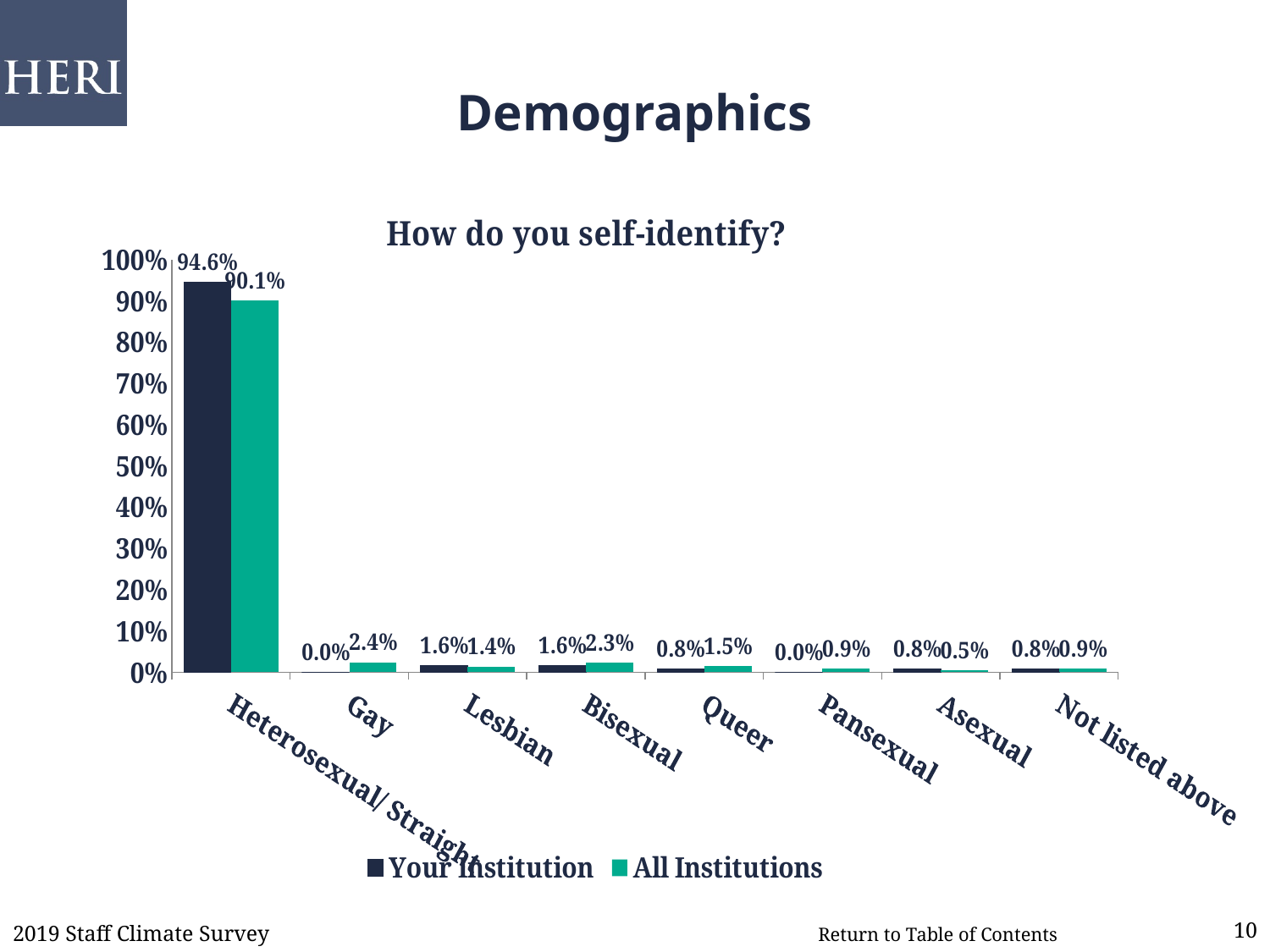
What kind of chart is shown on the slide? Bar chart What is the title of the chart? How do you self-identify? What is the Your Institution value for Bisexual? 1.6% Is the Your Institution value for Heterosexual/Straight greater or less than 90%? greater Which category has the highest value for All Institutions? Heterosexual/Straight What is the difference between the Your Institution and All Institutions values for Heterosexual/Straight? 4.5% What is the All Institutions value for Gay? 2.4% How many categories are shown on the x axis? 8 How many series does the legend list? 2 For Asexual, which series has the larger value, Your Institution or All Institutions? Your Institution What percentage of respondents at Your Institution self-identify as Heterosexual/Straight? 94.6% What is the All Institutions value for Queer? 1.5%